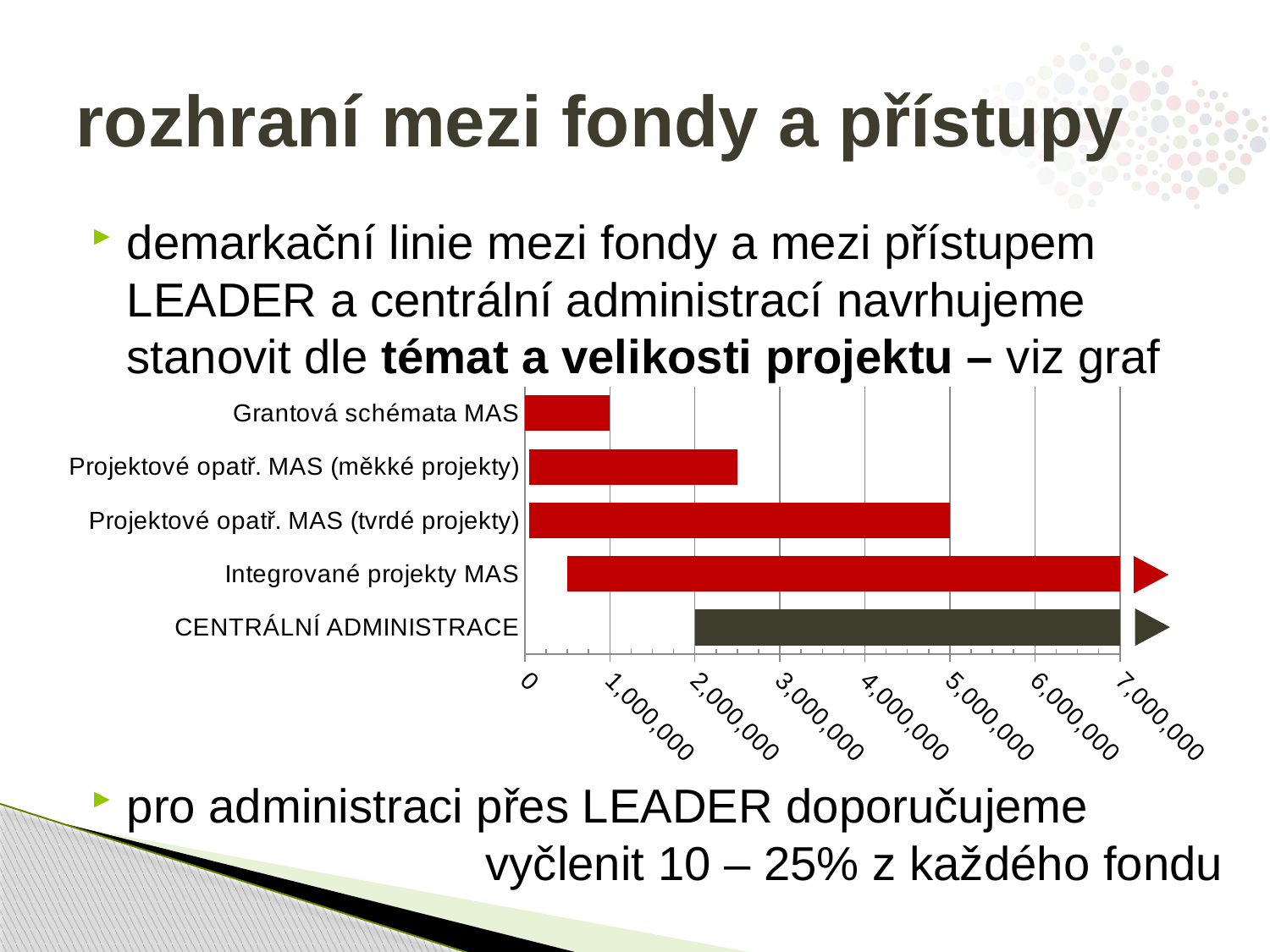
Which category has the shortest bar in the chart? Grantová schémata MAS At what value does the bar for Projektové opatř. MAS (tvrdé projekty) end? 5,000,000 Is the end value of the bar for Projektové opatř. MAS (měkké projekty) greater or less than 3,000,000? less Is the end value of the bar for Projektové opatř. MAS (měkké projekty) greater or less than 2,000,000? greater At what value does the bar for Grantová schémata MAS end? 1,000,000 At what value does the bar for CENTRÁLNÍ ADMINISTRACE start? 2,000,000 What kind of chart is shown on the slide? bar chart How many categories are plotted in the chart? 5 Which category's bar is drawn in dark grey rather than red? CENTRÁLNÍ ADMINISTRACE What is the difference between the end values of the bars for Projektové opatř. MAS (tvrdé projekty) and Grantová schémata MAS? 4,000,000 Which bar extends further: Projektové opatř. MAS (tvrdé projekty) or Projektové opatř. MAS (měkké projekty)? Projektové opatř. MAS (tvrdé projekty) Which bar is shorter: Grantová schémata MAS or Projektové opatř. MAS (měkké projekty)? Grantová schémata MAS